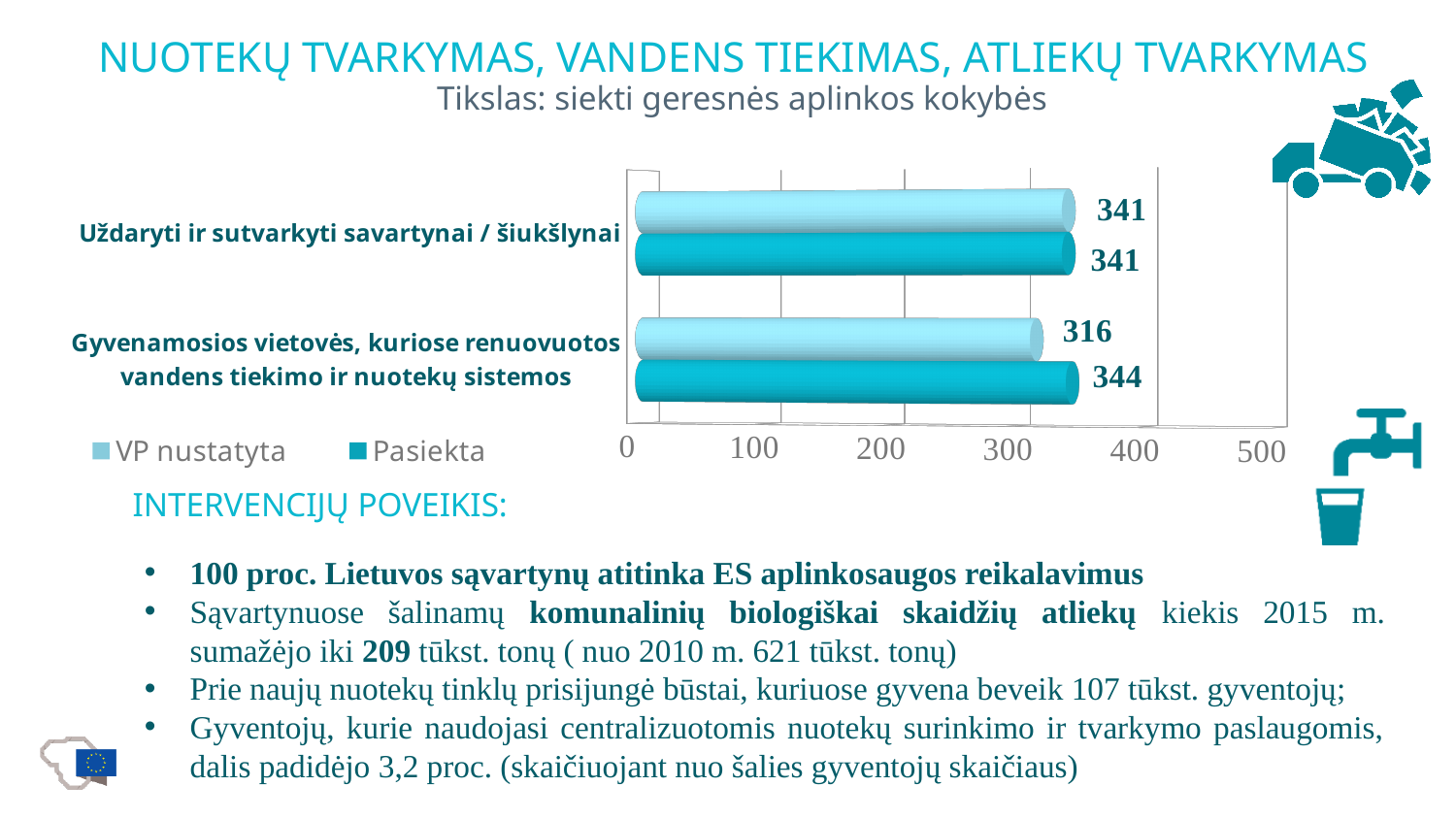
Which category has the lowest 'VP nustatyta' value? Gyvenamosios vietovės, kuriose renuovuotos vandens tiekimo ir nuotekų sistemos How many series does the chart legend list? 2 Is the 'VP nustatyta' value for 'Gyvenamosios vietovės, kuriose renuovuotos vandens tiekimo ir nuotekų sistemos' greater or less than 300? greater What kind of chart is shown on the slide? Bar chart How many categories are shown in the chart? 2 For 'Gyvenamosios vietovės, kuriose renuovuotos vandens tiekimo ir nuotekų sistemos', which is larger: 'VP nustatyta' or 'Pasiekta'? Pasiekta What is the 'VP nustatyta' value for 'Gyvenamosios vietovės, kuriose renuovuotos vandens tiekimo ir nuotekų sistemos'? 316 Which category has the highest 'Pasiekta' value? Gyvenamosios vietovės, kuriose renuovuotos vandens tiekimo ir nuotekų sistemos What is the 'VP nustatyta' value for 'Uždaryti ir sutvarkyti savartynai / šiukšlynai'? 341 What is the 'Pasiekta' value for 'Uždaryti ir sutvarkyti savartynai / šiukšlynai'? 341 What is the 'Pasiekta' value for 'Gyvenamosios vietovės, kuriose renuovuotos vandens tiekimo ir nuotekų sistemos'? 344 What is the difference between the 'Pasiekta' and 'VP nustatyta' values for 'Gyvenamosios vietovės, kuriose renuovuotos vandens tiekimo ir nuotekų sistemos'? 28